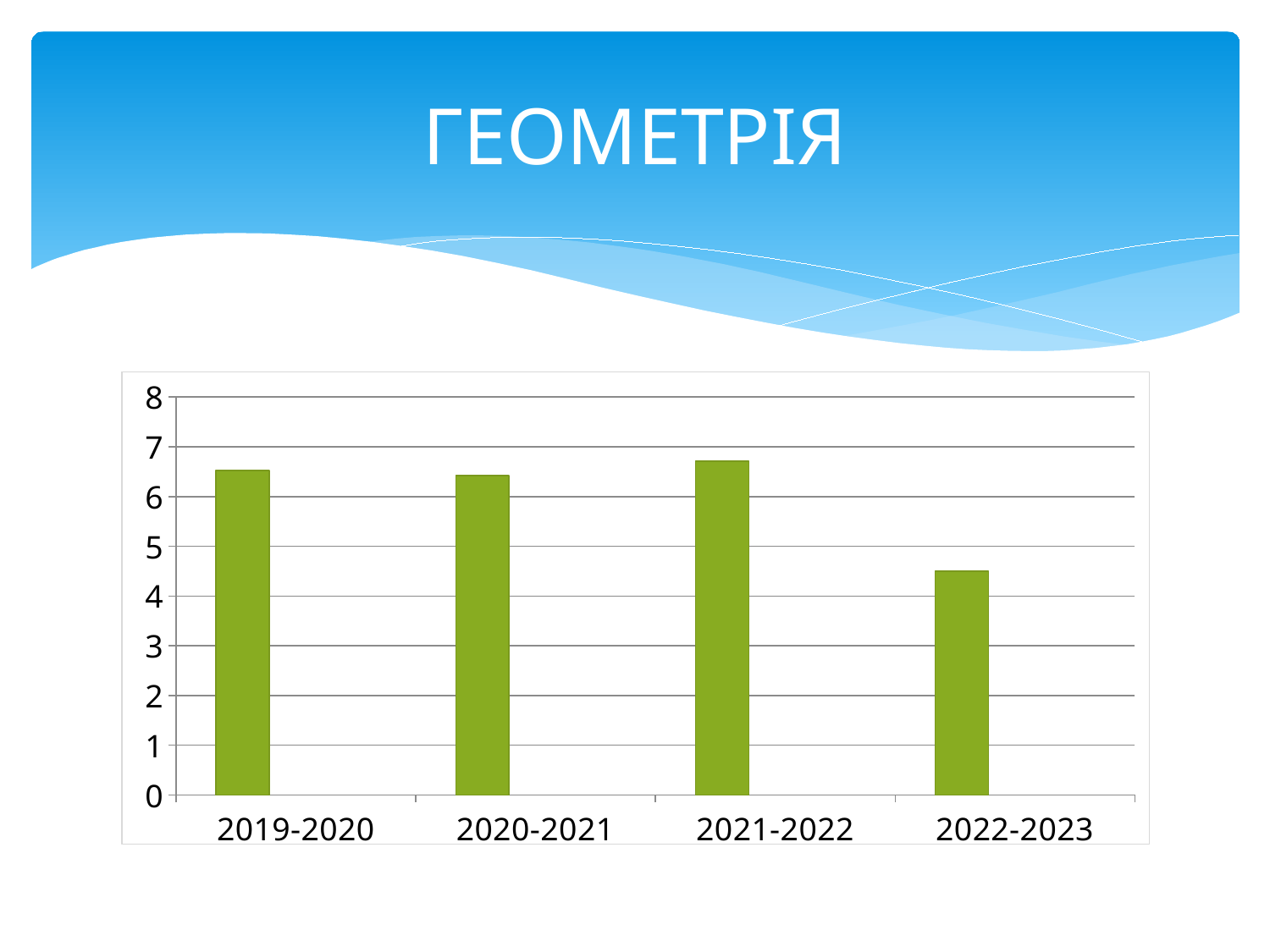
Which is larger, the value for 2019-2020 or the value for 2022-2023? 2019-2020 What is the highest tick value shown on the vertical axis of the chart? 8 Is the value for 2019-2020 greater or less than 7? less Which school year has the highest bar in the chart? 2021-2022 Which school year has the lowest bar in the chart? 2022-2023 How many categories (school years) are shown on the x axis of the chart? 4 Is the value for 2022-2023 greater or less than 5? less Which is larger, the value for 2021-2022 or the value for 2022-2023? 2021-2022 Does the value rise or fall from 2021-2022 to 2022-2023? fall Is the value for 2020-2021 greater or less than 6? greater What kind of chart is shown on the slide? bar chart